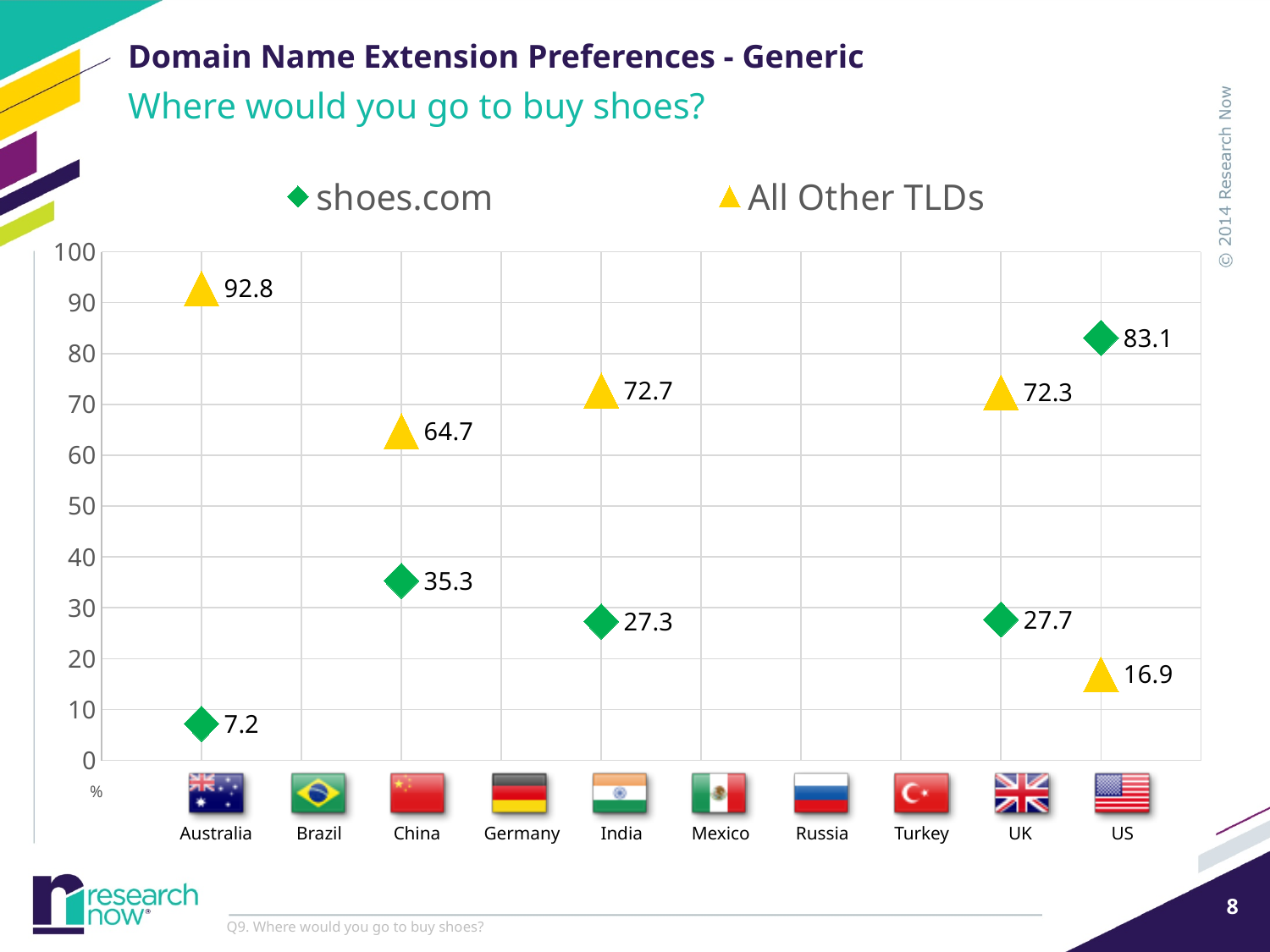
Which country has the highest shoes.com value? US Which has the larger shoes.com value, India or the UK? UK How many series does the legend list? 2 What is the All Other TLDs value for the UK? 72.3 For Australia, how much higher is the All Other TLDs value than the shoes.com value? 85.6 For the US, what is the difference between the shoes.com value and the All Other TLDs value? 66.2 What is the shoes.com value for the US? 83.1 What is the All Other TLDs value for Australia? 92.8 How many countries are labelled along the x axis? 10 Which country has the lowest shoes.com value? Australia What is the shoes.com value for China? 35.3 Which country has the highest All Other TLDs value? Australia